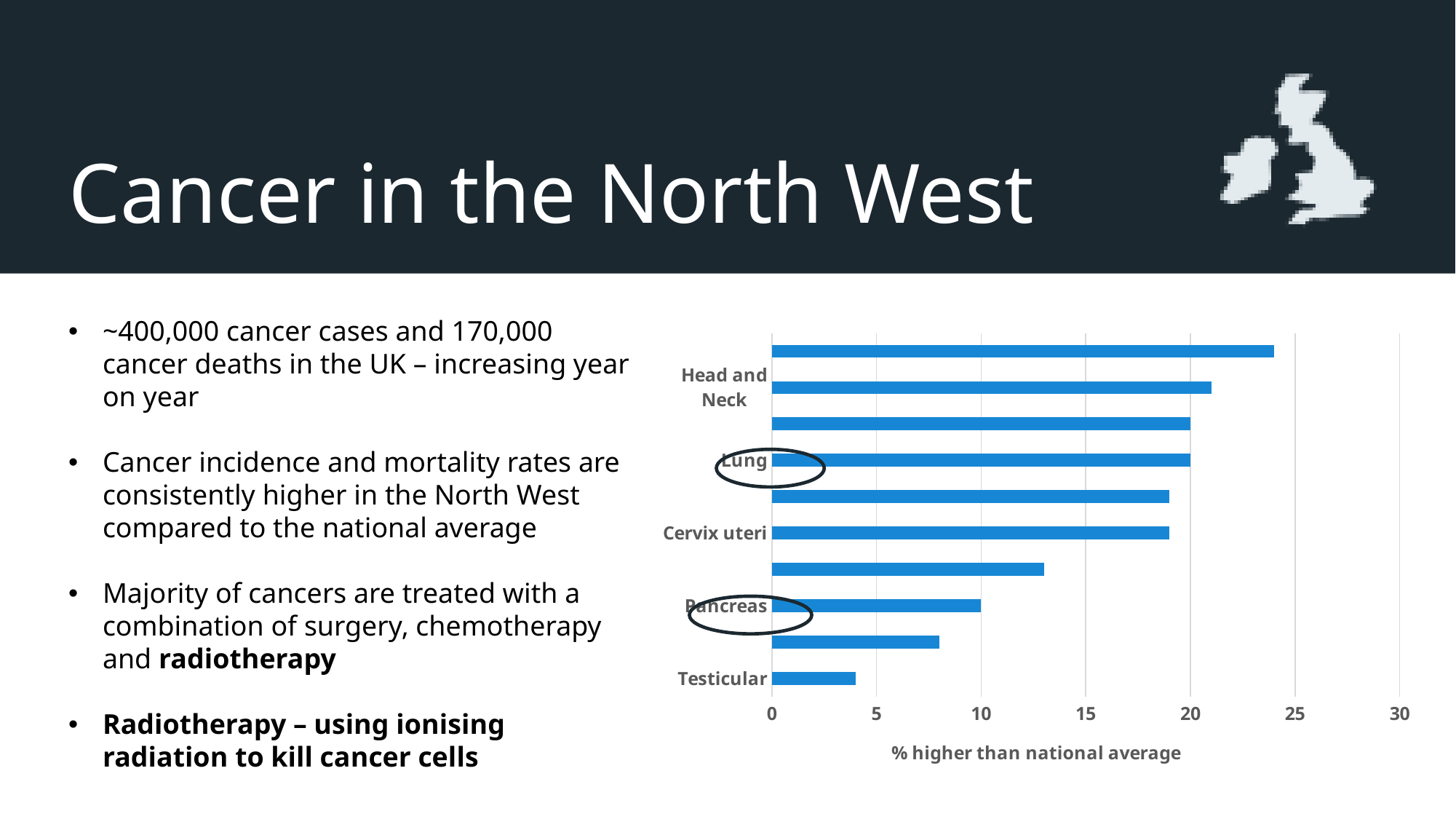
Which has a larger value, Pancreas or Cervix uteri? Cervix uteri What is the title of the horizontal axis of the chart? % higher than national average Do the bar values increase or decrease going from the top of the chart to the bottom? decrease Which has a larger value, Head and Neck or Testicular? Head and Neck Is the value for Pancreas greater or less than 15? less Is the value for Lung greater or less than 10? greater Is the value for Cervix uteri greater or less than 15? greater Which category has the lowest value in the chart? Testicular What kind of chart is shown on the slide? bar chart How many bars are plotted in the chart? 10